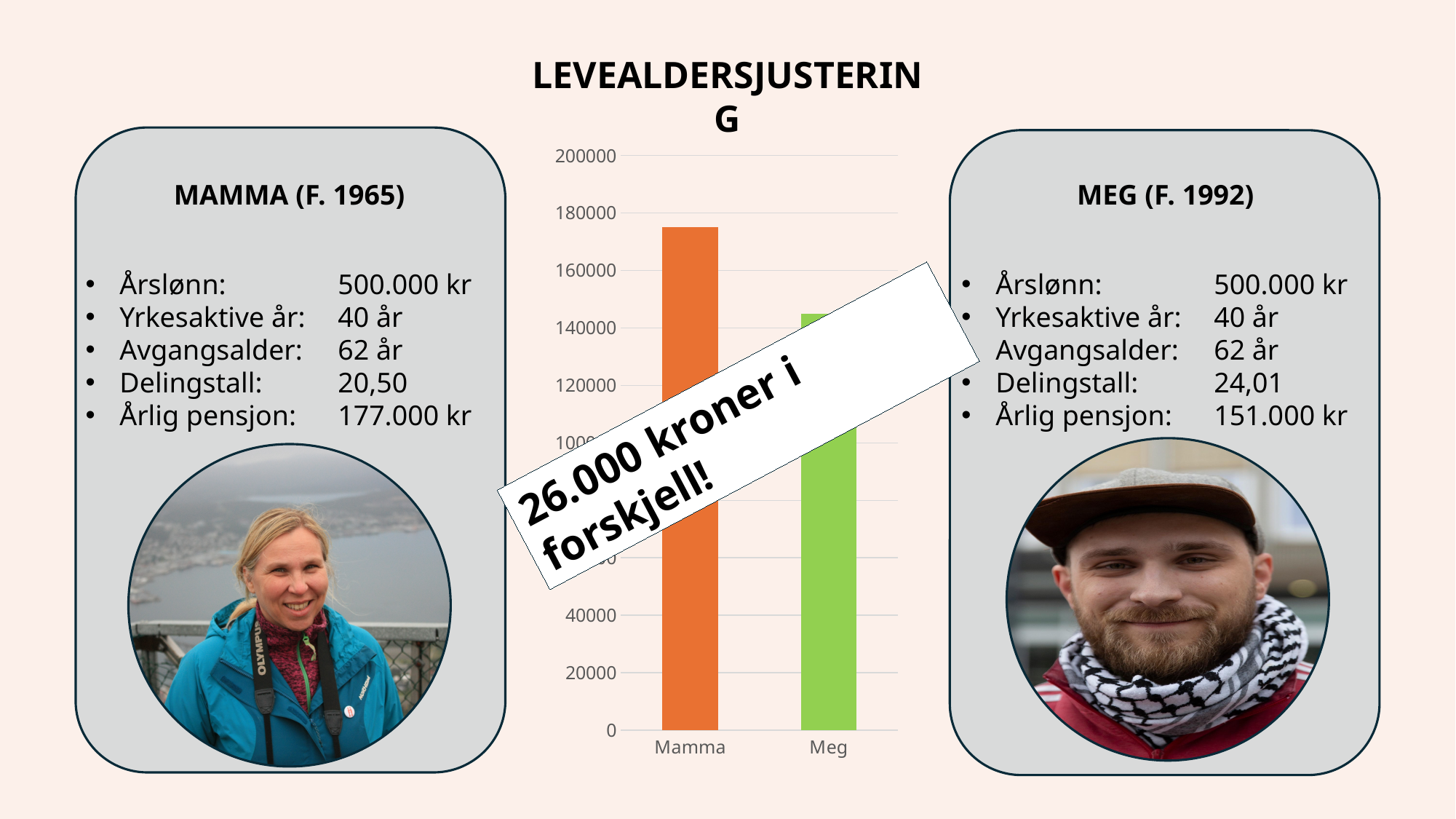
Is the value for Meg greater or less than 140000? greater How many categories are shown on the x axis of the chart? 2 Is the value for Mamma greater or less than 180000? less Is the value for Mamma greater or less than 160000? greater What is the title of the chart? LEVEALDERSJUSTERING What kind of chart is shown on the slide? bar chart Which category has the lowest bar in the chart? Meg Do the bar values rise or fall from Mamma to Meg along the x axis? fall Which category has the highest bar in the chart? Mamma Which bar is taller, Mamma or Meg? Mamma What colour is the bar for Meg? green